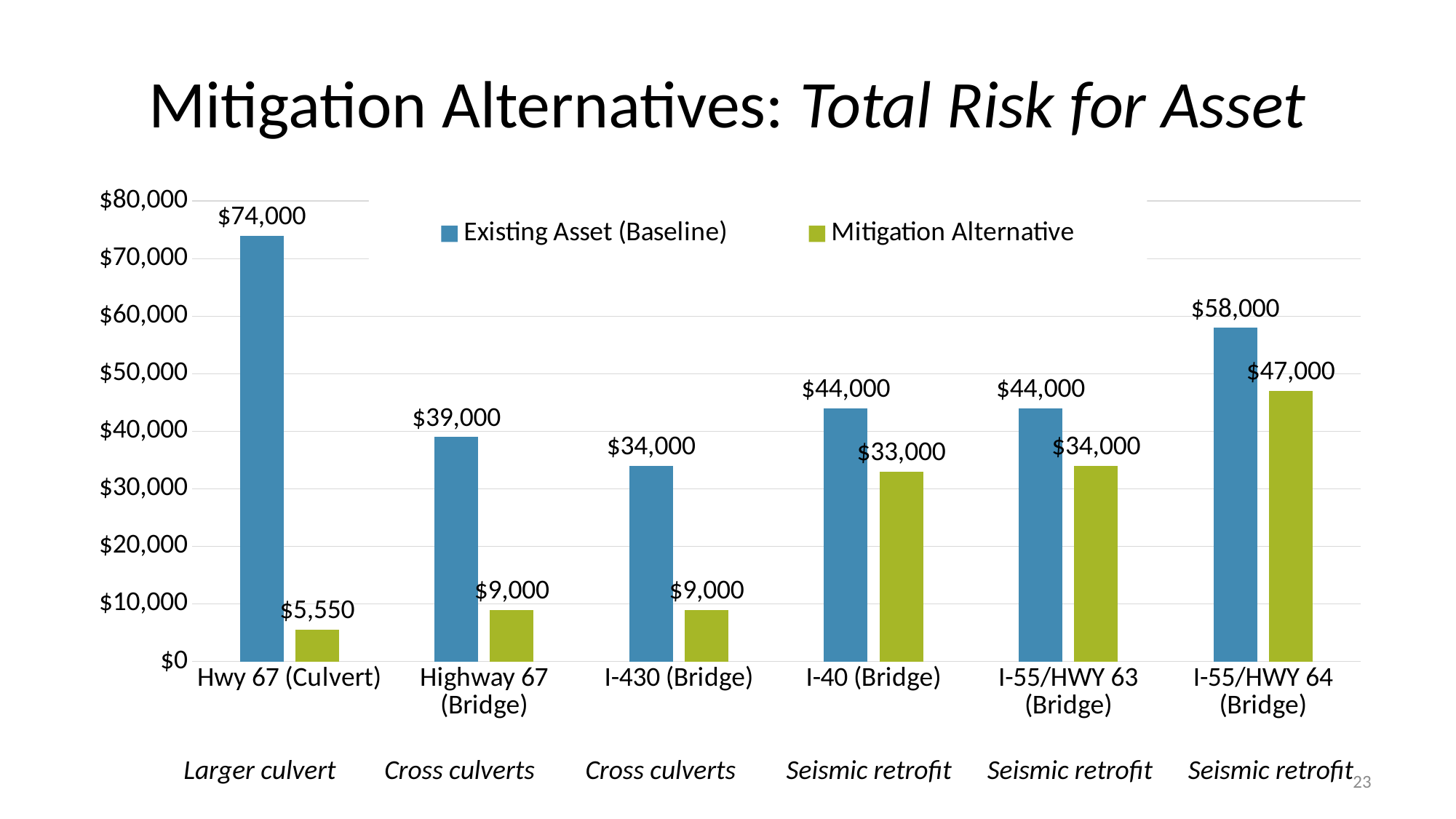
What is the difference between the Existing Asset (Baseline) and Mitigation Alternative values for Highway 67 (Bridge)? $30,000 What kind of chart is shown on the slide? Bar chart Which is larger for I-55/HWY 64 (Bridge): the Existing Asset (Baseline) value or the Mitigation Alternative value? Existing Asset (Baseline) What is the Existing Asset (Baseline) value for Hwy 67 (Culvert)? $74,000 What is the Mitigation Alternative value for I-55/HWY 64 (Bridge)? $47,000 What is the Mitigation Alternative value for Hwy 67 (Culvert)? $5,550 Which category has the lowest Mitigation Alternative value? Hwy 67 (Culvert) What colour are the Mitigation Alternative bars? Green Which category has the highest Existing Asset (Baseline) value? Hwy 67 (Culvert) How many categories are shown on the x axis? 6 How many series does the legend list? 2 What is the difference between the Existing Asset (Baseline) and Mitigation Alternative values for I-40 (Bridge)? $11,000